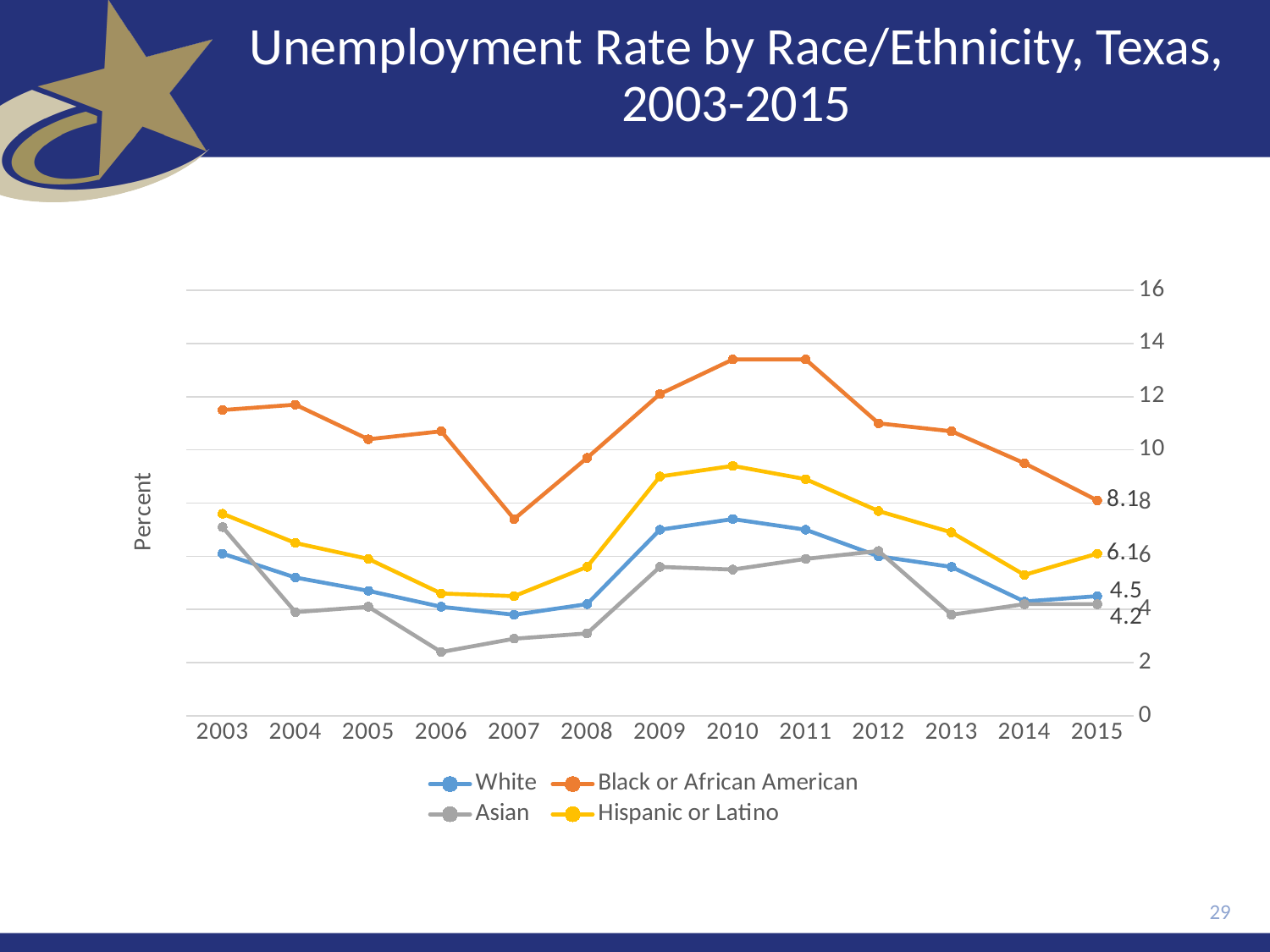
Which group had the highest unemployment rate in 2010? Black or African American Does the Black or African American unemployment rate rise or fall from 2011 to 2015? fall What is the difference between the Black or African American and Hispanic or Latino unemployment rates in 2015? 2.02 What kind of chart is shown on the slide? line chart What is the unemployment rate for White in 2015? 4.5 What is the unemployment rate for Black or African American in 2015? 8.18 How many years are shown on the x axis? 13 What is the unemployment rate for Hispanic or Latino in 2015? 6.16 Is the value for Asian in 2006 greater or less than 4? less How many series does the legend list? 4 What is the unemployment rate for Asian in 2015? 4.2 Is the value for Black or African American in 2010 greater or less than 12? greater